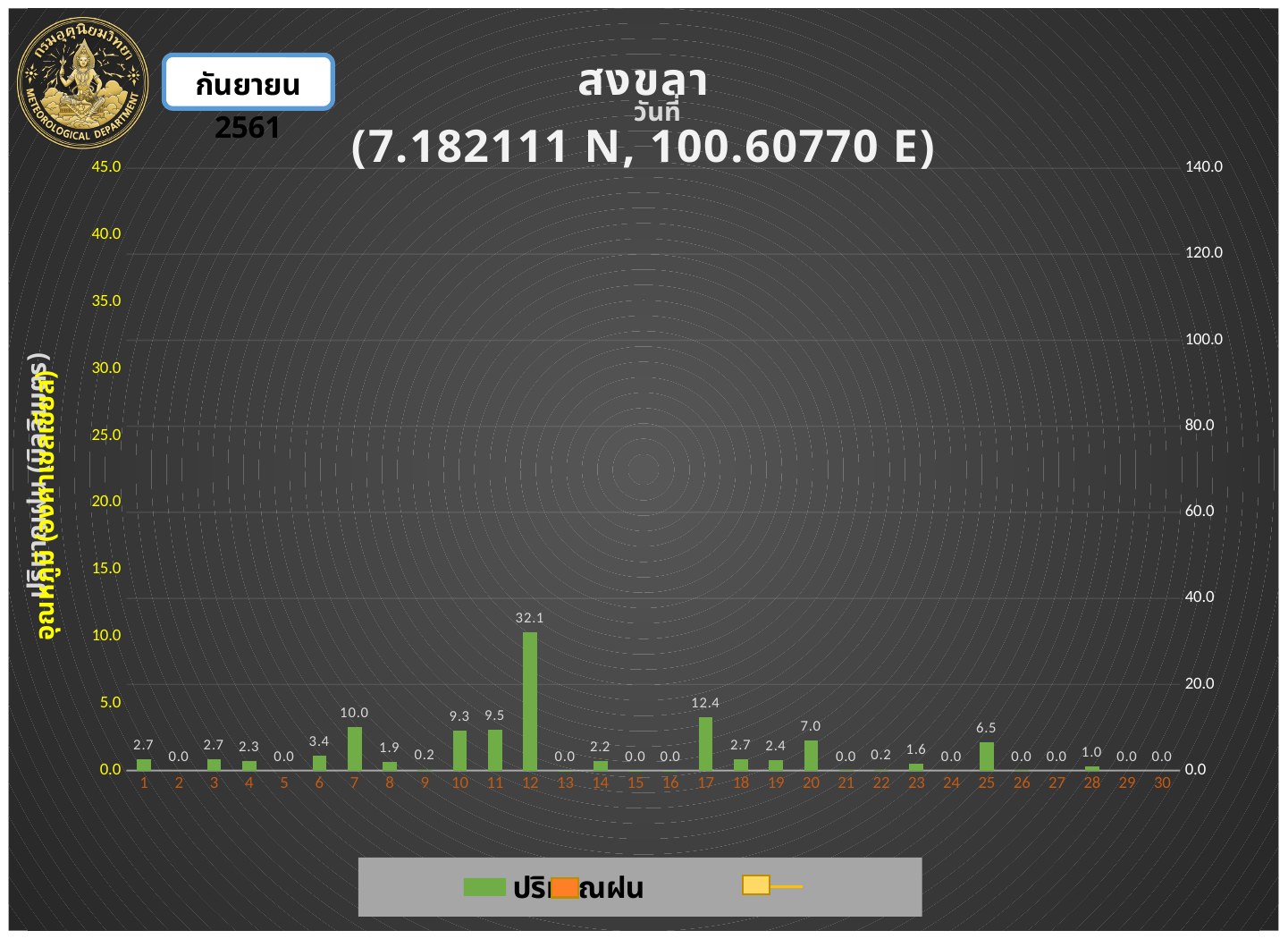
Which is larger, the value for day 6 or the value for day 8? day 6 Which day has the highest bar in the chart? 12 What is the value shown for day 25? 6.5 What is the difference between the values for day 11 and day 10? 0.2 What kind of chart is shown on the slide? bar chart How many days are shown on the x axis of the chart? 30 What value is labelled for day 7? 10.0 Which is larger, the value for day 20 or the value for day 25? day 20 What is the value of the bar for day 17? 12.4 What colour are the bars in the chart? green What is the difference between the values for day 12 and day 17? 19.7 What is the rainfall value shown for day 12? 32.1